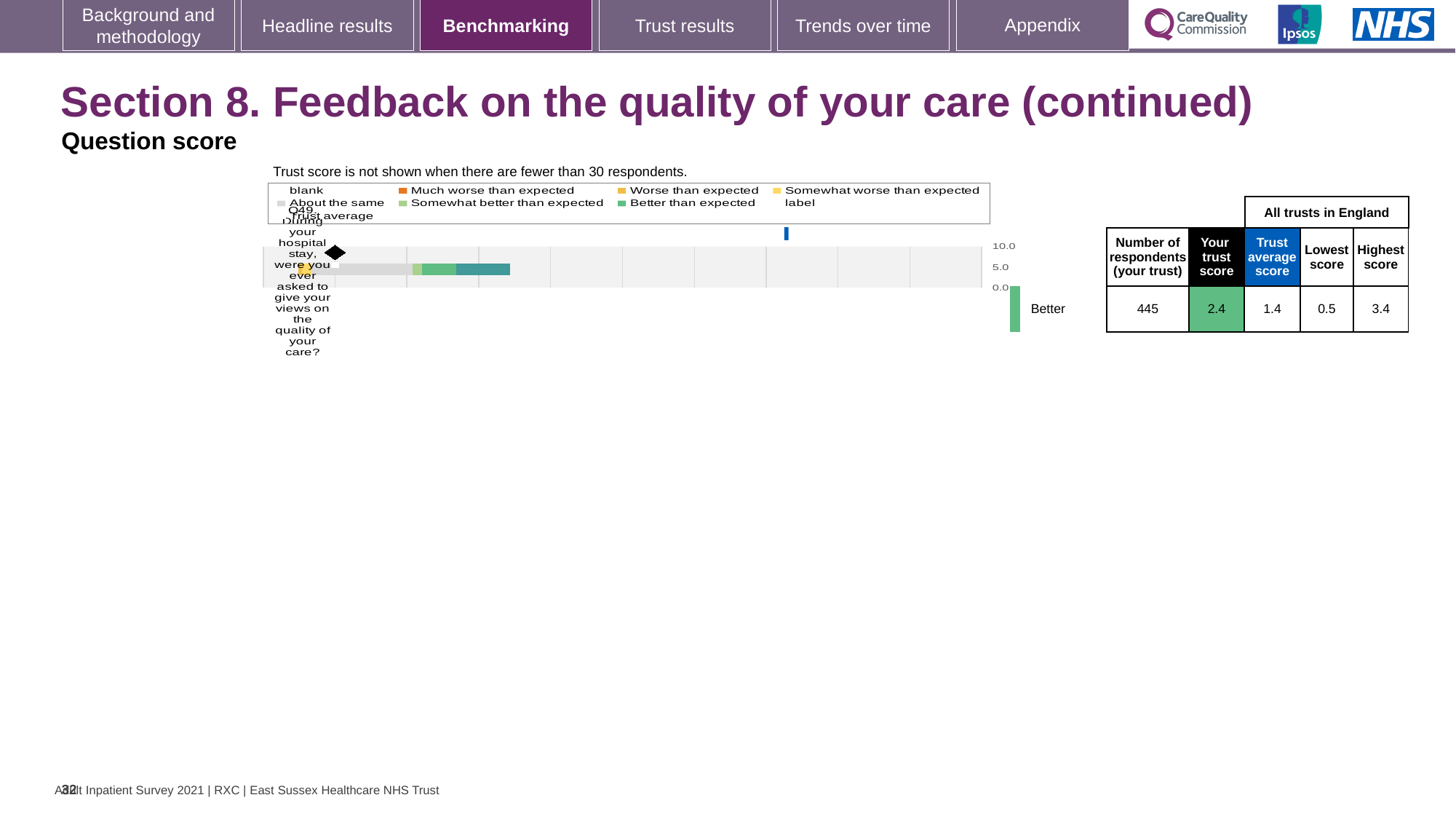
Which is larger for Q49: your trust score or the trust average score? your trust score In the table beside the chart, what is the trust average score for all trusts in England? 1.4 In the table beside the chart, what is the highest score among all trusts in England? 3.4 What colour does the legend use for 'Much worse than expected'? orange In the table beside the chart, what is your trust score for Q49? 2.4 In the table beside the chart, what is the number of respondents for your trust? 445 What is the difference between your trust score (2.4) and the trust average score (1.4) for Q49? 1.0 What word is printed next to the green bar to the right of the chart? Better Which survey question number is plotted in the chart? Q49 What kind of chart is shown on the slide for Q49? bar chart In the table beside the chart, what is the lowest score among all trusts in England? 0.5 What is the difference between the highest score (3.4) and the lowest score (0.5) for Q49? 2.9